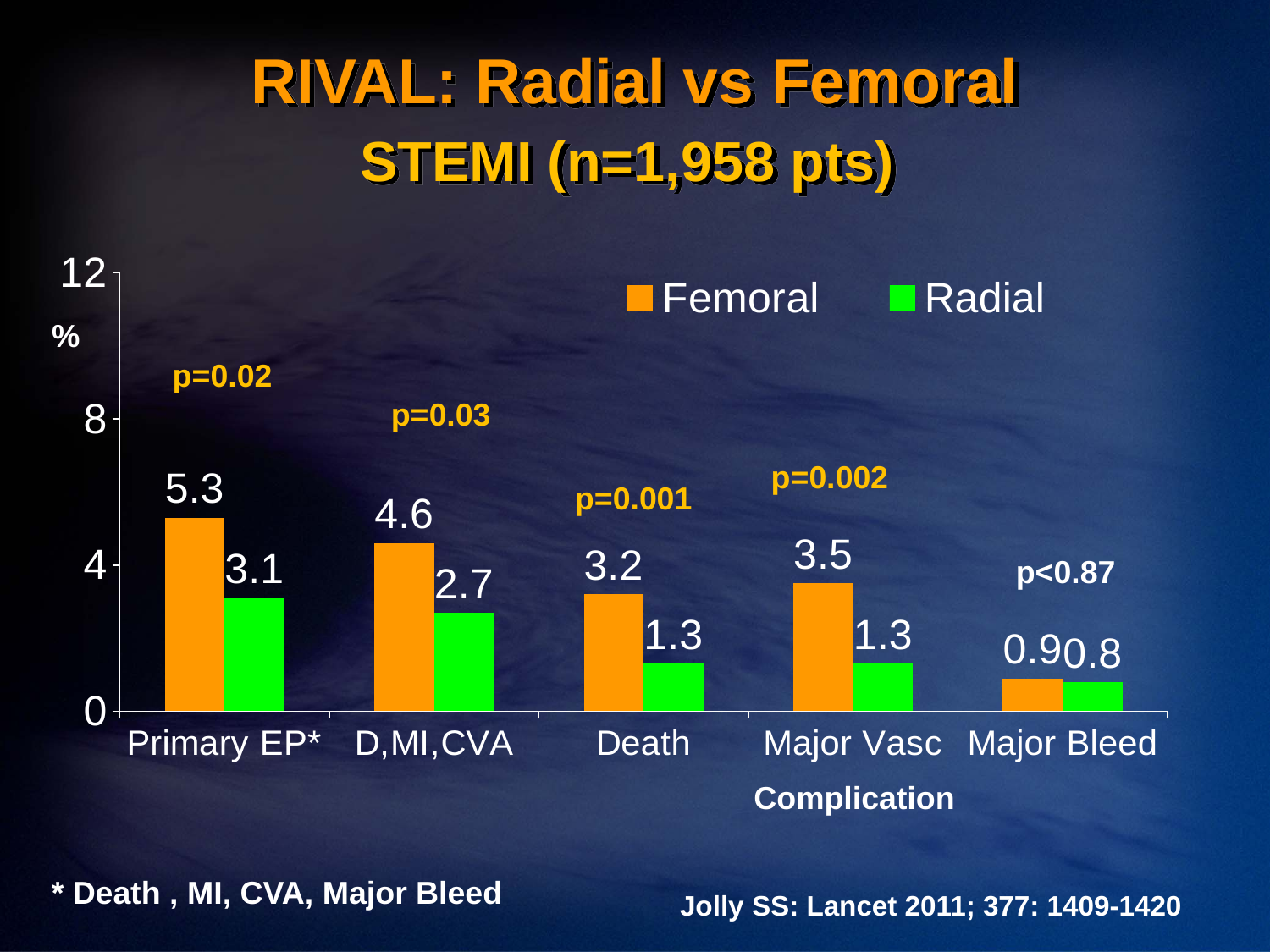
Which complication has the highest Femoral value? Primary EP* Which is larger for Major Vasc, the Femoral value or the Radial value? Femoral What kind of chart is shown on the slide? Bar chart What is the Radial value for Major Vasc? 1.3 How many series does the legend list? 2 What is the difference between the Femoral and Radial values for Death? 1.9 Which colour represents the Radial series? Green What is the difference between the Femoral and Radial values for Primary EP*? 2.2 How many complication categories are shown on the x axis? 5 Which complication has the lowest Radial value? Major Bleed What is the Radial value for D,MI,CVA? 2.7 What is the Femoral value for Primary EP*? 5.3